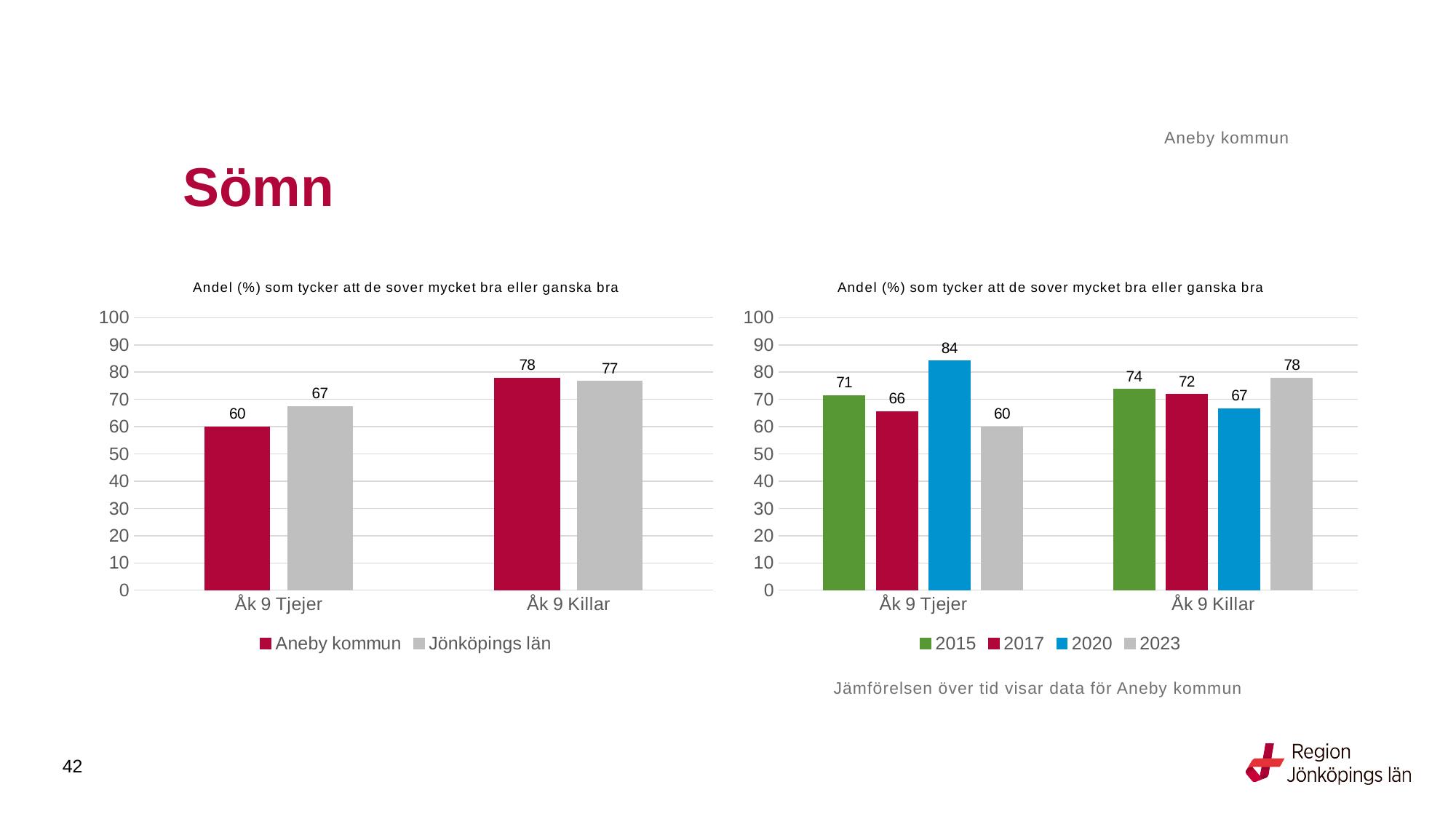
In the left chart, which is larger for Åk 9 Killar: Aneby kommun or Jönköpings län? Aneby kommun In the right chart, what is the value for 2020 for Åk 9 Tjejer? 84 In the left chart, what is the difference between Aneby kommun and Jönköpings län for Åk 9 Tjejer? 7 In the left chart, how many series does the legend list? 2 What kind of chart is the left chart? Bar chart In the right chart, what is the difference between the 2020 and 2023 values for Åk 9 Tjejer? 24 In the right chart, which year has the lowest value for Åk 9 Killar? 2020 In the left chart, what is the value for Jönköpings län for Åk 9 Killar? 77 In the right chart, which year has the highest value for Åk 9 Tjejer? 2020 In the left chart, what is the value for Aneby kommun for Åk 9 Tjejer? 60 In the right chart, what is the value for 2023 for Åk 9 Killar? 78 In the right chart, how many series does the legend list? 4